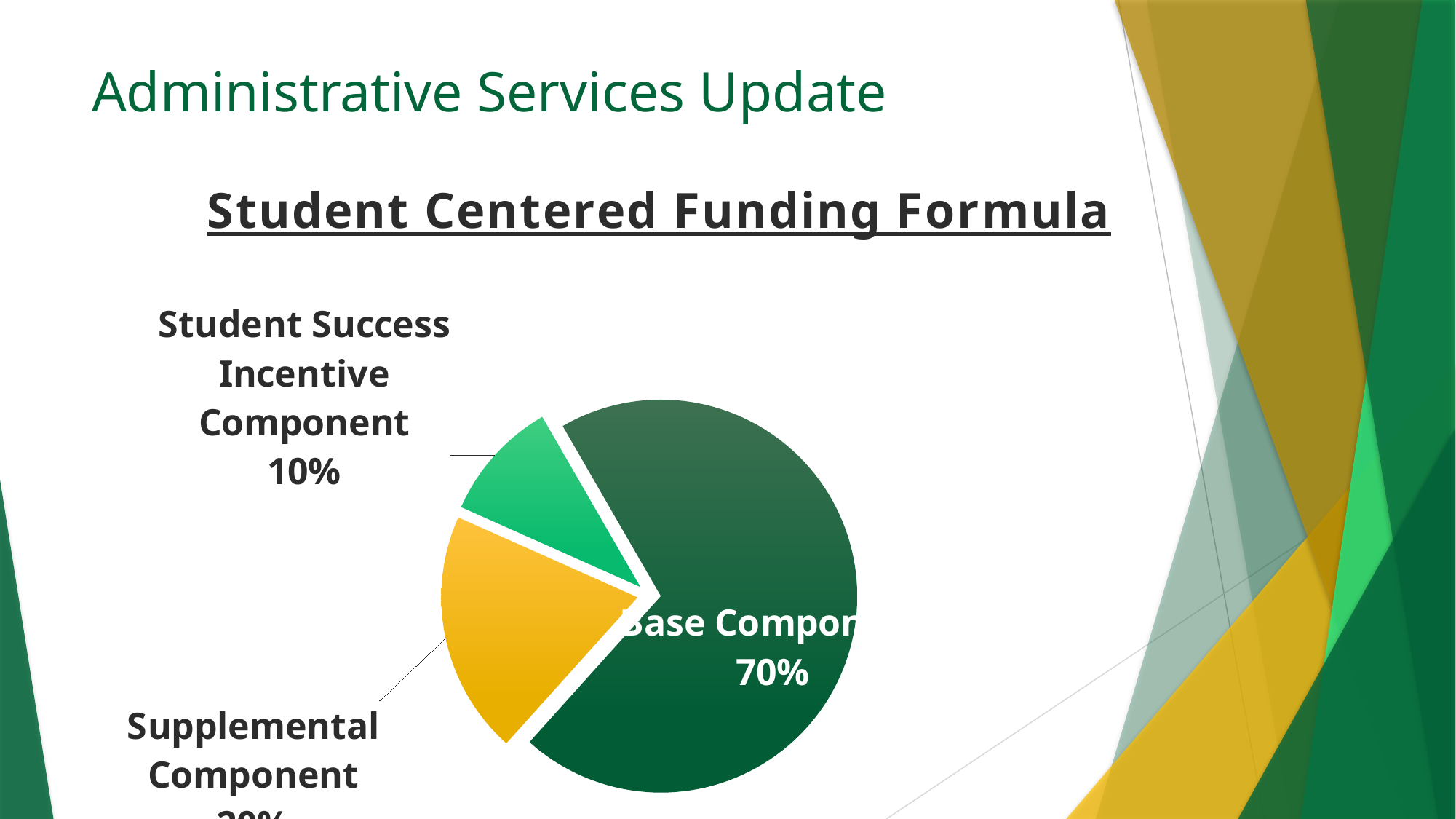
What share of the pie does the Base Component represent? 70% Which is larger, the Base Component or the Supplemental Component? Base Component Which is larger, the Supplemental Component or the Student Success Incentive Component? Supplemental Component What is the difference in percentage points between the Base Component and the Student Success Incentive Component? 60 What colour is the Base Component slice? dark green How many slices does the pie chart have? 3 Which component has the smallest slice of the pie? Student Success Incentive Component What kind of chart is shown on the slide? pie chart What share of the pie does the Student Success Incentive Component represent? 10% Which component has the largest slice of the pie? Base Component What is the title of the chart? Student Centered Funding Formula